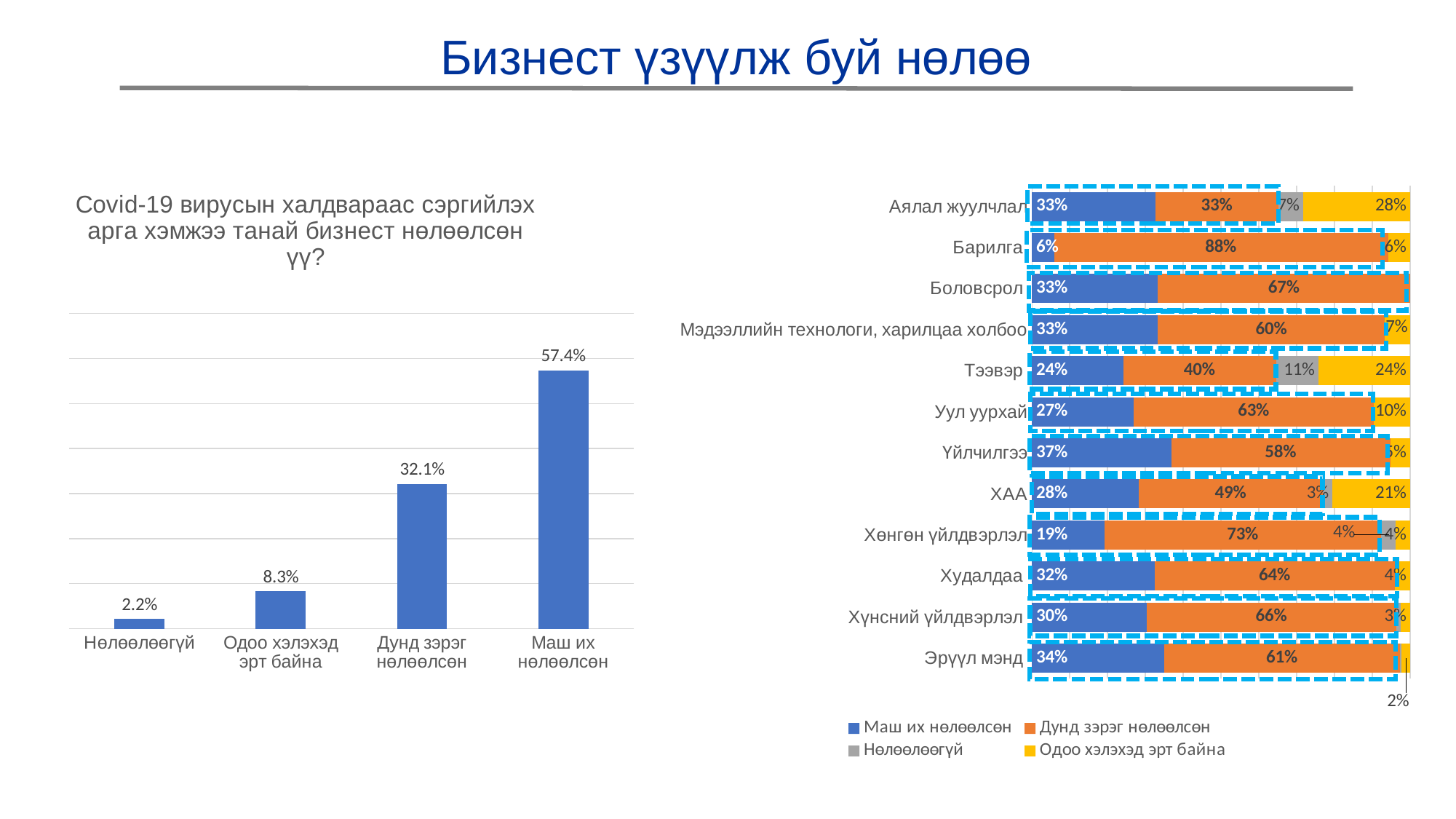
What kind of chart is the left chart? Bar chart In the right chart, how many series does the legend list? 4 In the right chart, how many industry categories are listed? 12 In the left chart, what is the difference between 'Маш их нөлөөлсөн' and 'Дунд зэрэг нөлөөлсөн'? 25.3% In the left chart, which category has the highest value? Маш их нөлөөлсөн In the left chart, what is the value for 'Нөлөөлөөгүй'? 2.2% In the right chart, what is the 'Маш их нөлөөлсөн' value for 'Үйлчилгээ'? 37% In the right chart, what is the 'Дунд зэрэг нөлөөлсөн' value for 'Барилга'? 88% In the left chart, how many categories are shown? 4 In the right chart, which is larger: the 'Маш их нөлөөлсөн' value for 'Тээвэр' or for 'Эрүүл мэнд'? Эрүүл мэнд In the left chart, what is the value for 'Маш их нөлөөлсөн'? 57.4% In the left chart, which category has the lowest value? Нөлөөлөөгүй